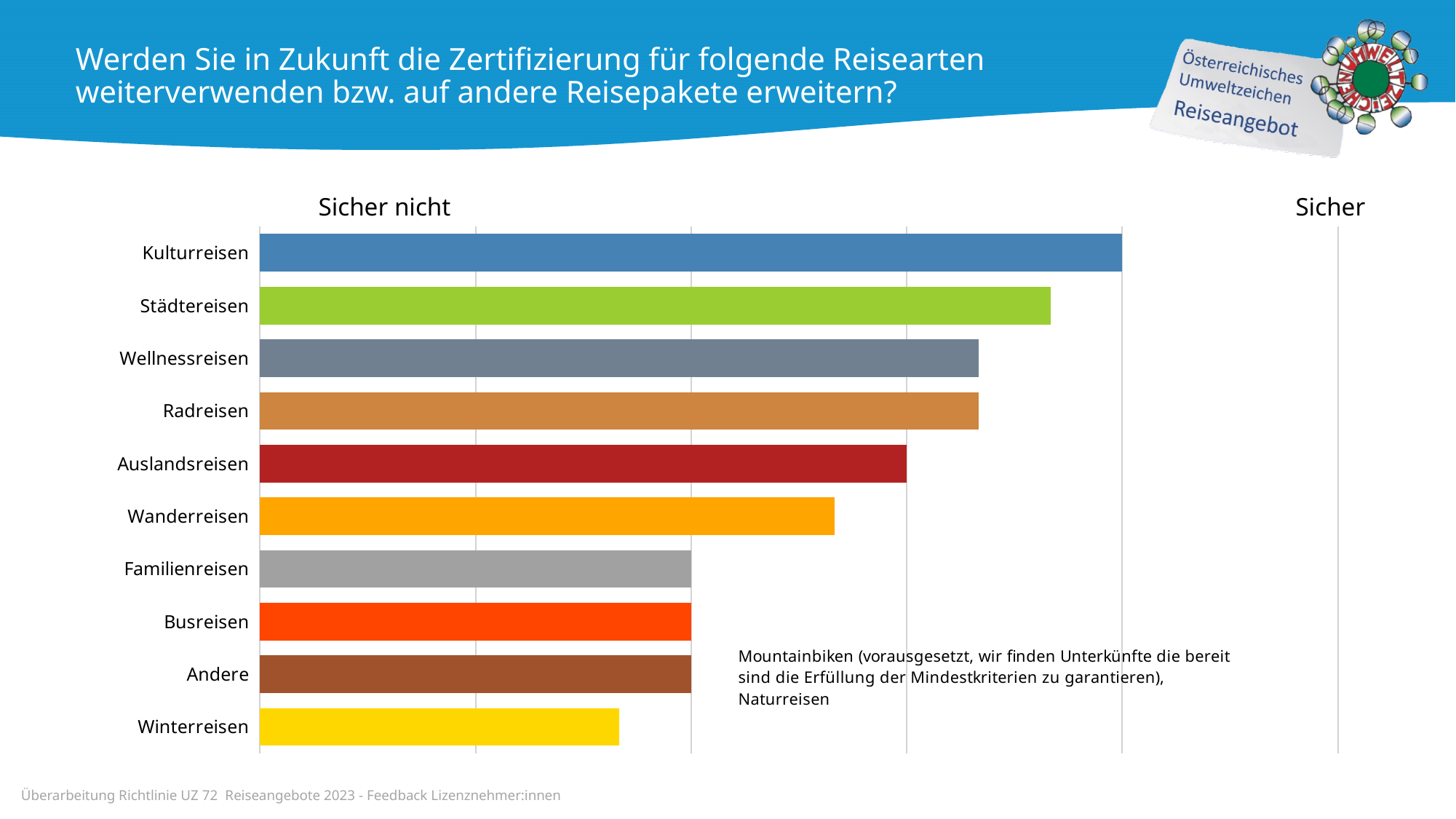
Which travel type has the shortest bar, i.e. the lowest value? Winterreisen Which has the larger value, Wanderreisen or Familienreisen? Wanderreisen Which has the larger value, Winterreisen or Busreisen? Busreisen What label appears at the right end of the horizontal axis? Sicher Which has the larger value, Auslandsreisen or Wanderreisen? Auslandsreisen What kind of chart is shown on the slide? bar chart Which travel type has the longest bar, i.e. the highest value? Kulturreisen What label appears at the left end of the horizontal axis? Sicher nicht How many travel types (categories) are shown in the chart? 10